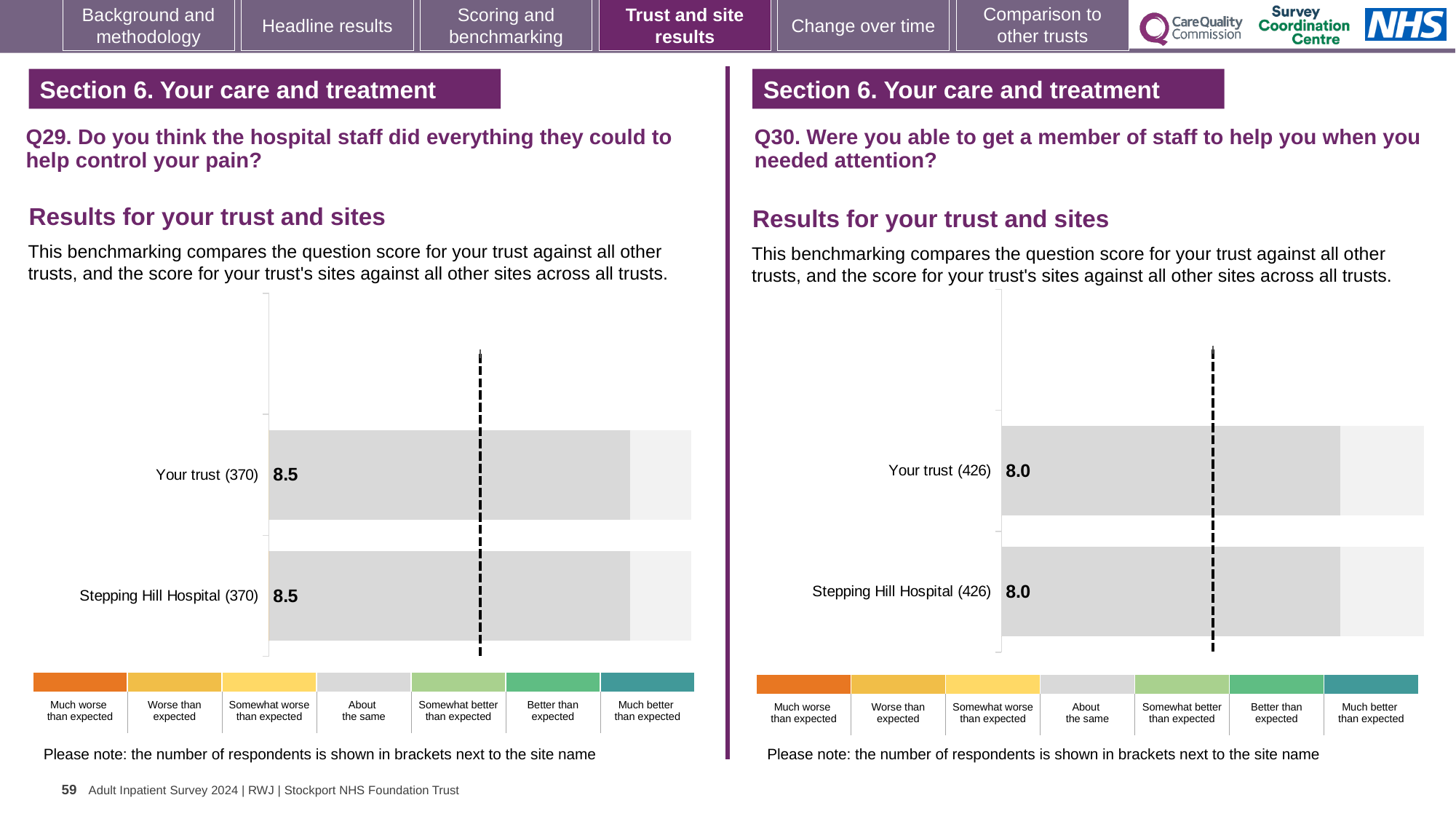
On the Q29 chart (left), what is the difference between the Your trust score and the Stepping Hill Hospital score? 0.0 On the Q30 chart (right), how many respondents are shown in brackets for Stepping Hill Hospital? 426 On the Q30 chart (right), what is the score for Stepping Hill Hospital? 8.0 On the Q29 chart (left), what is the score for Your trust? 8.5 On the Q29 chart (left), what is the score for Stepping Hill Hospital? 8.5 On the Q30 chart (right), what is the difference between the Your trust score and the Stepping Hill Hospital score? 0.0 How many bars are plotted on the Q29 chart (left)? 2 On the Q29 chart (left), how many respondents are shown in brackets for Your trust? 370 What type of chart is used on the Q29 chart (left)? Bar chart Is the Your trust score on the Q29 chart (left) larger than the Your trust score on the Q30 chart (right)? Yes On the Q30 chart (right), what is the score for Your trust? 8.0 How many bars are plotted on the Q30 chart (right)? 2